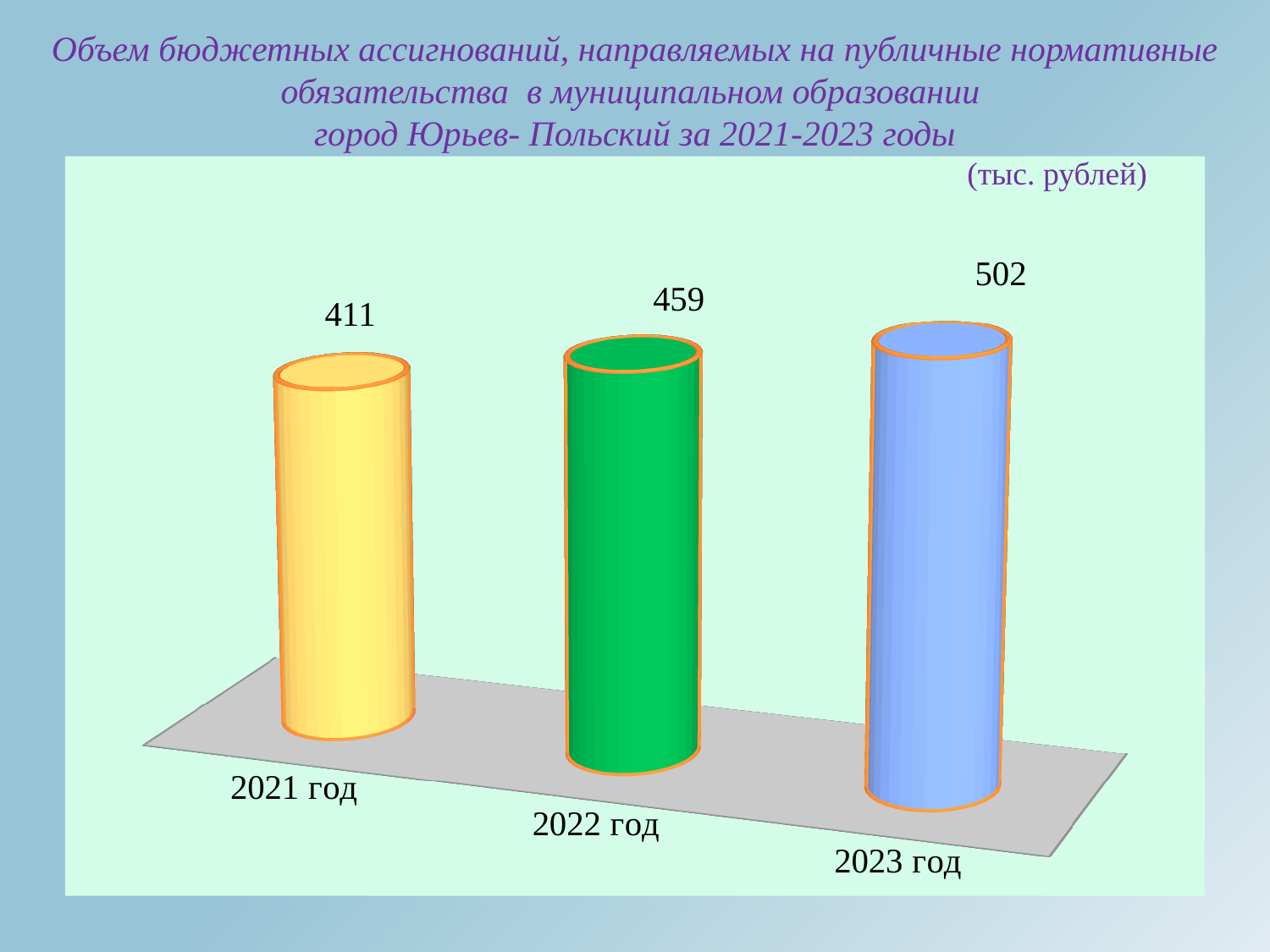
What is the value for 2022 год? 459 What is the value for 2023 год? 502 Which year has the lowest value? 2021 год What kind of chart is shown on the slide? bar chart In what units are the values on the chart given? тыс. рублей What is the value for 2021 год? 411 Which is larger, the value for 2022 год or the value for 2023 год? 2023 год What is the difference between the values for 2022 год and 2021 год? 48 Do the values rise or fall from 2021 год to 2023 год? rise How many years are shown on the chart? 3 What is the difference between the values for 2023 год and 2021 год? 91 Which year has the highest value? 2023 год